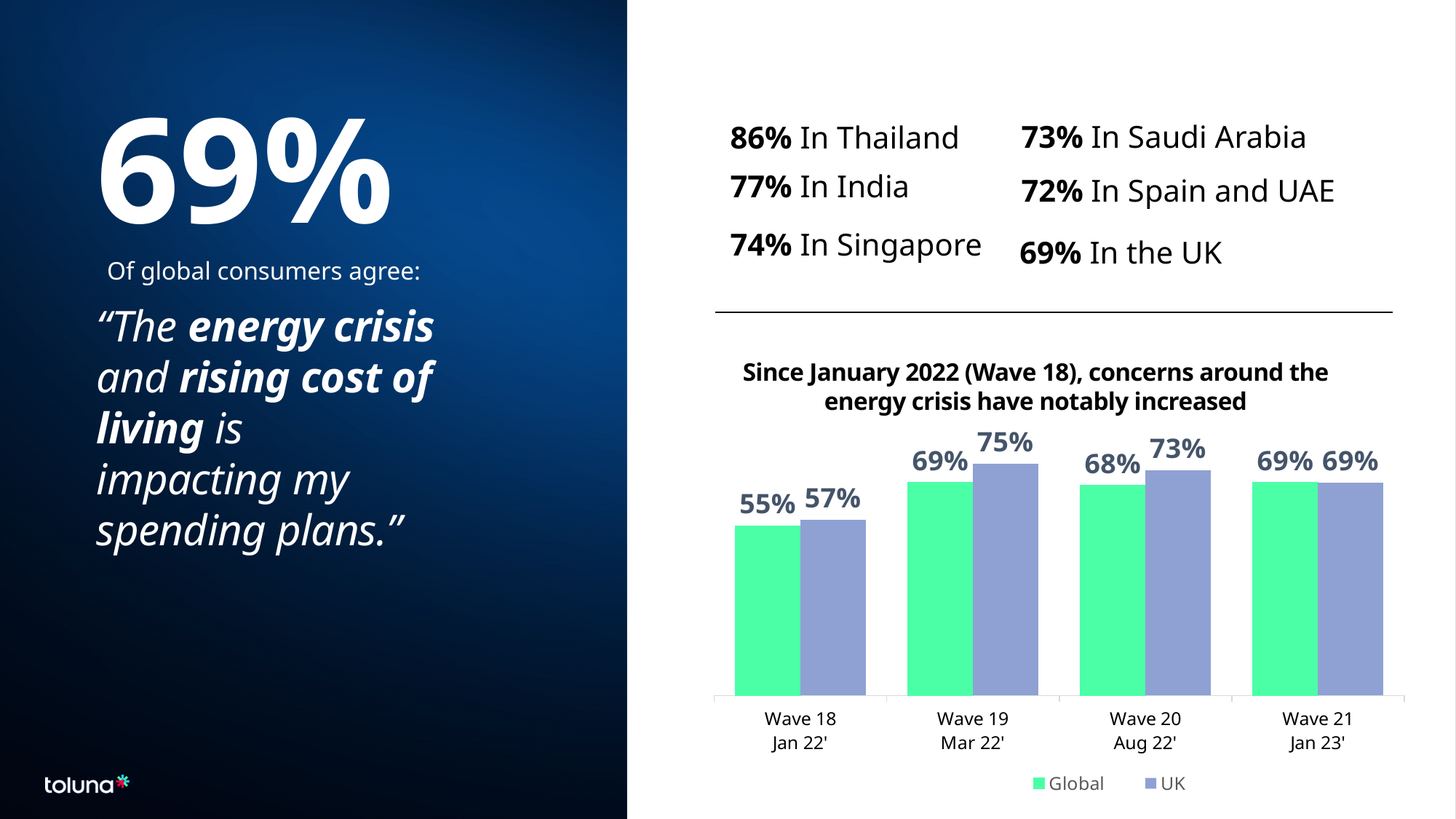
What is the Global value for Wave 18 (Jan 22')? 55% Which colour represents the Global series in the chart? Green What is the Global value for Wave 20 (Aug 22')? 68% What kind of chart is shown on the slide? Bar chart How many series does the chart legend list? 2 How many waves are shown on the x axis of the chart? 4 What is the UK value for Wave 21 (Jan 23')? 69% In which wave is the UK value highest? Wave 19 What is the UK value for Wave 19 (Mar 22')? 75% In which wave is the Global value lowest? Wave 18 Which is larger for Wave 20: the Global value or the UK value? UK What is the difference between the UK and Global values for Wave 19? 6%